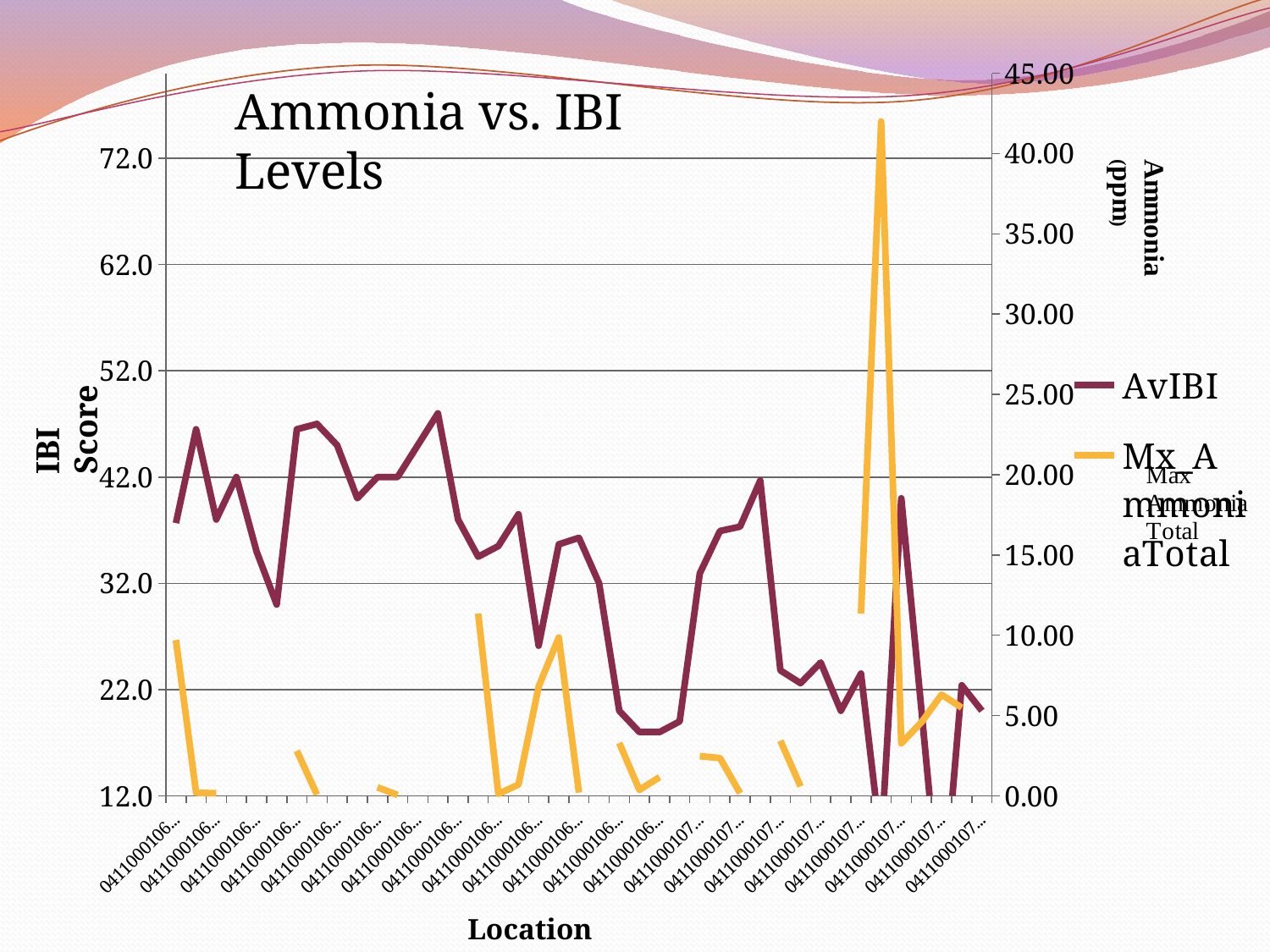
Is the lowest value of the AvIBI series greater or less than 22.0? less Is the highest value of the AvIBI series greater or less than 52.0? less Which series is drawn in yellow? Mx_AmmoniaTotal What is the title of the chart? Ammonia vs. IBI Levels What kind of chart is shown on the slide? line chart How many series does the legend list? 2 Is the highest value of the Mx_AmmoniaTotal series greater or less than 40.00 ppm? greater Overall, does the AvIBI series rise or fall from the left of the x axis to the right? fall